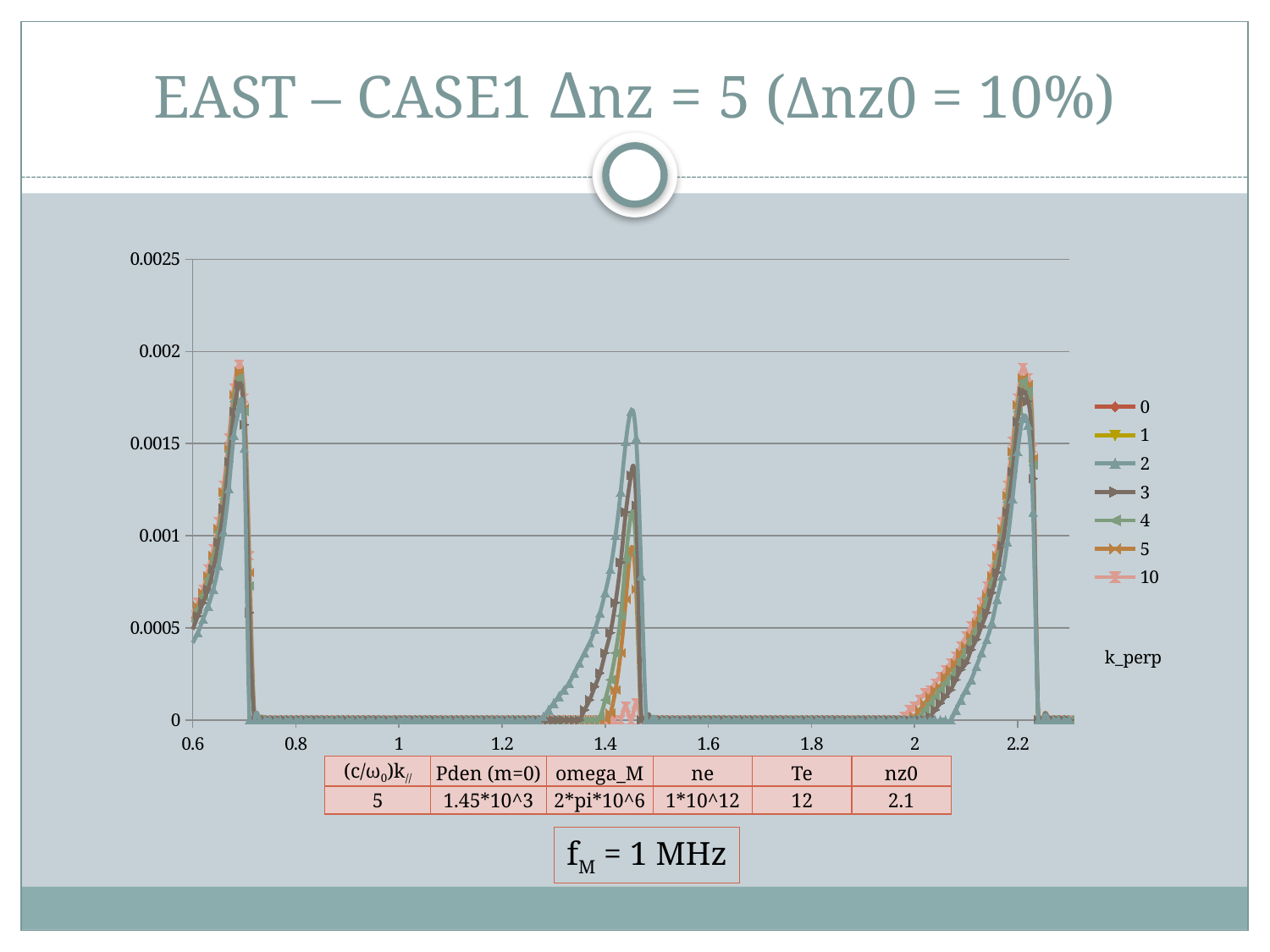
What is the title shown under the legend? k_perp What are the series labels listed in the legend? 0, 1, 2, 3, 4, 5, 10 Is the peak value of series 3 near x = 1.45 greater or less than 0.0015? less How many distinct peaks do the curves show across the x axis? 3 How many series does the legend list? 7 What kind of chart is shown on the slide? line chart What is the highest value labelled on the y axis? 0.0025 What value do all the series take at x = 1.0? 0 Is the peak value of the curves near x = 0.7 greater or less than 0.002? less What is the lowest value labelled on the x axis? 0.6 Which series reaches the highest peak near x = 1.45? 2 Is the peak value of series 2 near x = 1.45 greater or less than 0.0015? greater